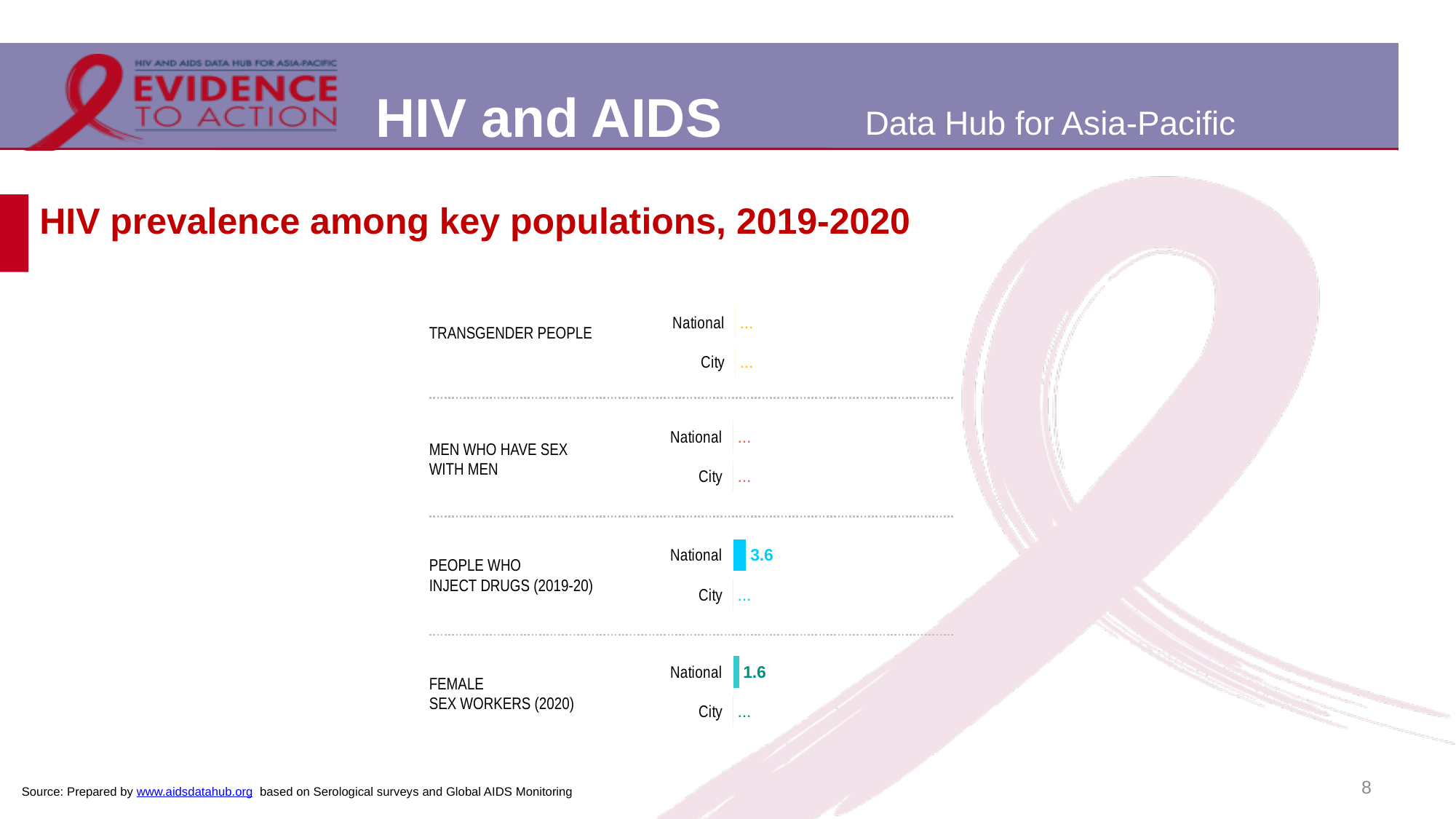
How many key population groups are listed on the chart? 4 What is the difference between the national HIV prevalence for people who inject drugs and for female sex workers? 2.0 Which key population has the lowest national HIV prevalence value printed on the chart? Female sex workers (2020) What is shown for the city HIV prevalence value for transgender people? … What kind of chart is used to show HIV prevalence among key populations? Bar chart What two levels are shown for each key population on the chart? National and City How many key populations have a national HIV prevalence value printed on the chart? 2 What is the title of the chart on the slide? HIV prevalence among key populations, 2019-2020 What is the national HIV prevalence value shown for female sex workers (2020)? 1.6 Which is larger: the national HIV prevalence for people who inject drugs or for female sex workers? People who inject drugs What is the national HIV prevalence value shown for people who inject drugs (2019-20)? 3.6 Which key population has the highest national HIV prevalence value printed on the chart? People who inject drugs (2019-20)